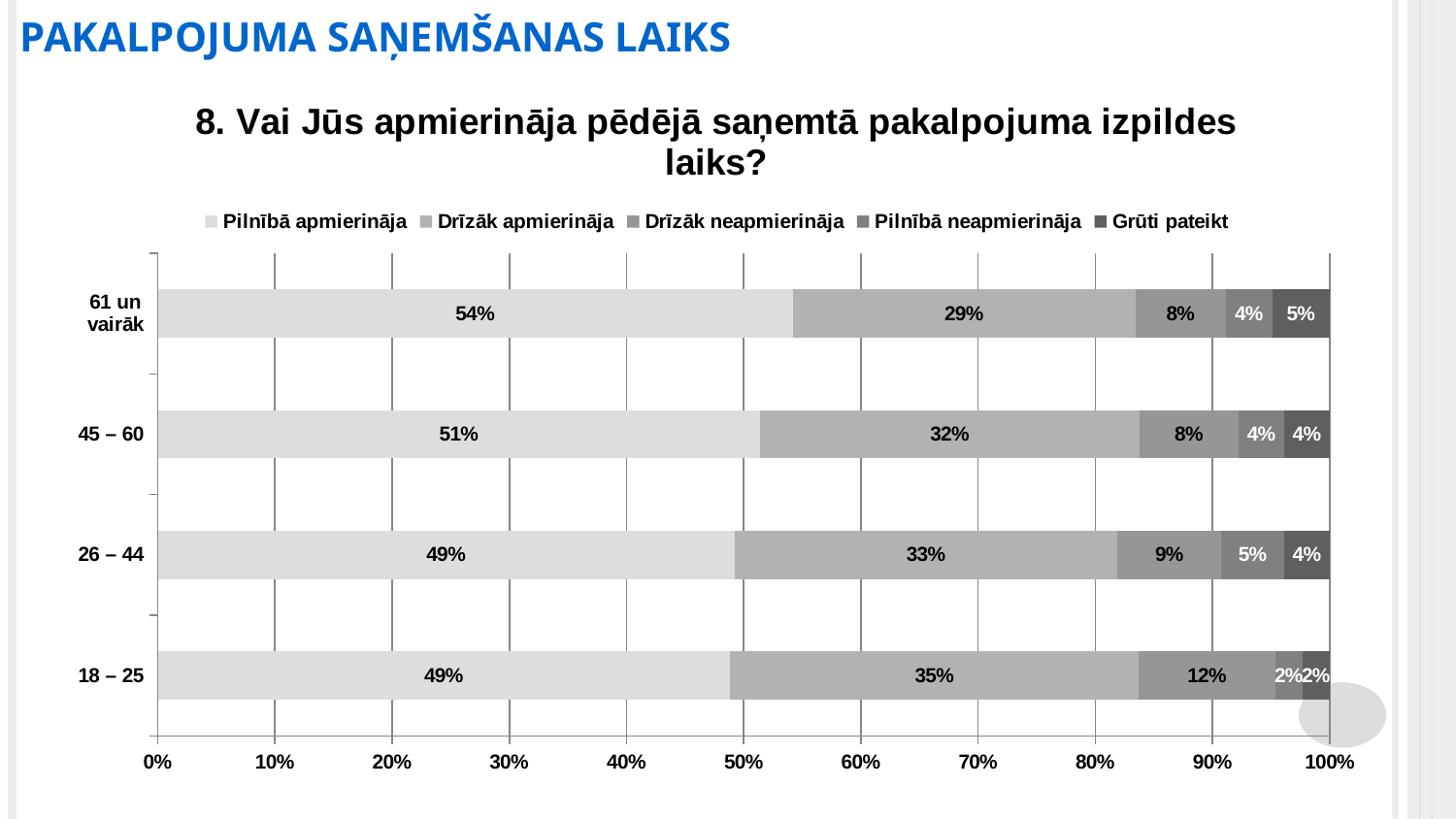
What percentage of the 61 un vairāk group answered Pilnībā apmierināja? 54% Which age group has the lowest share of Drīzāk apmierināja? 61 un vairāk What percentage of the 45 – 60 group answered Grūti pateikt? 4% How many age groups are shown on the chart? 4 Which is larger: the Pilnībā apmierināja share for 45 – 60 or for 26 – 44? 45 – 60 What percentage of the 26 – 44 group answered Drīzāk neapmierināja? 9% What is the difference between the Drīzāk neapmierināja share for 18 – 25 and for 45 – 60? 4 percentage points What is the last entry in the chart legend? Grūti pateikt How many series does the legend list? 5 What percentage of the 18 – 25 group answered Drīzāk apmierināja? 35% Which age group has the highest share of Pilnībā apmierināja? 61 un vairāk What type of chart is shown on the slide? Stacked bar chart